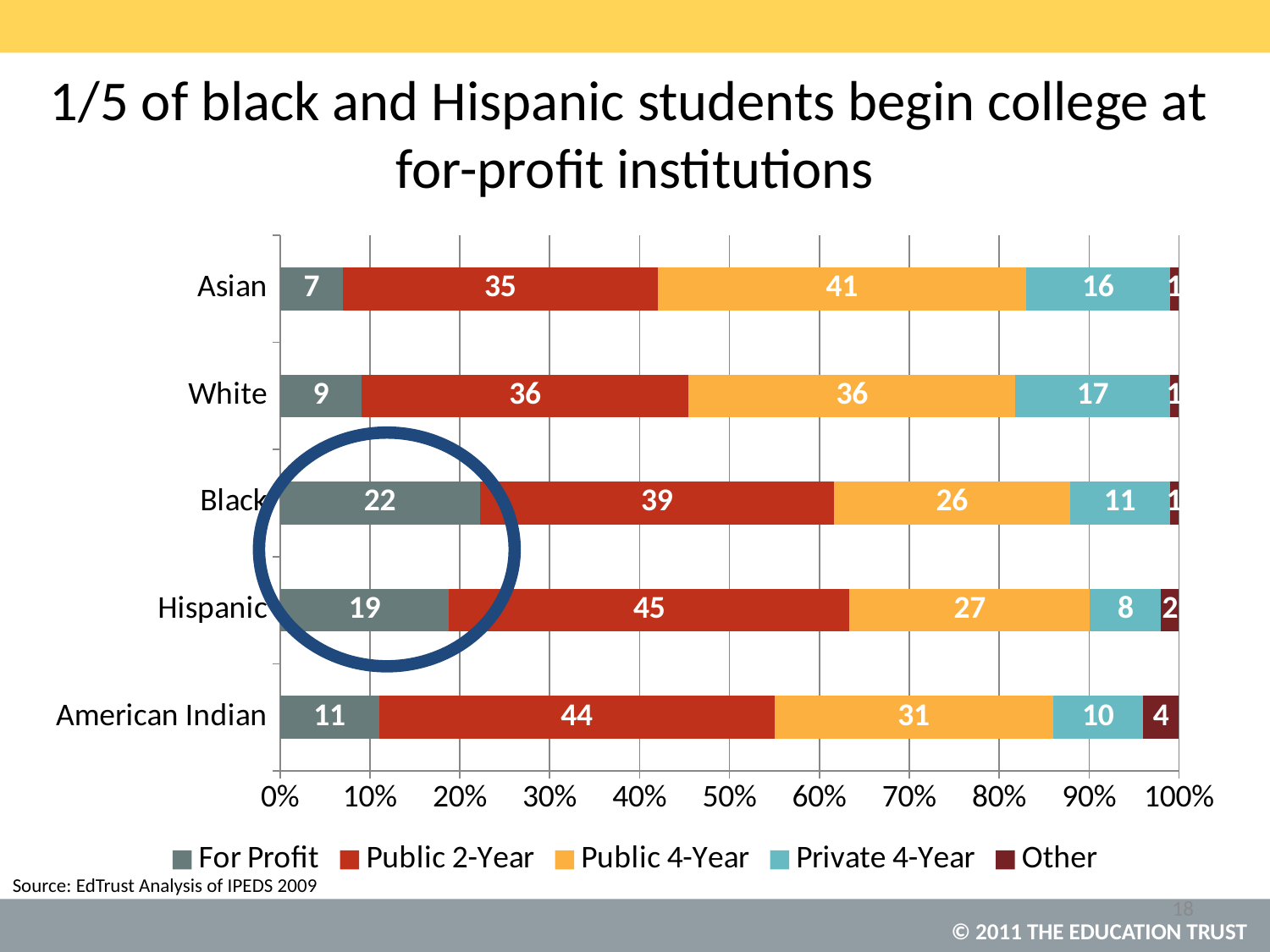
Which category has the highest For Profit value? Black How many series does the legend list? 5 What kind of chart is shown on the slide? Stacked bar chart What is the Public 4-Year value for Asian students? 41 What is the difference between the For Profit values for Black and Hispanic students? 3 Which category has the lowest For Profit value? Asian What is the For Profit value for Black students? 22 Which is larger, the Public 2-Year value for American Indian students or for Hispanic students? Hispanic What is the total of the stacked bar for American Indian students? 100 What is the Private 4-Year value for White students? 17 How many categories are shown on the chart? 5 What is the Public 2-Year value for Hispanic students? 45